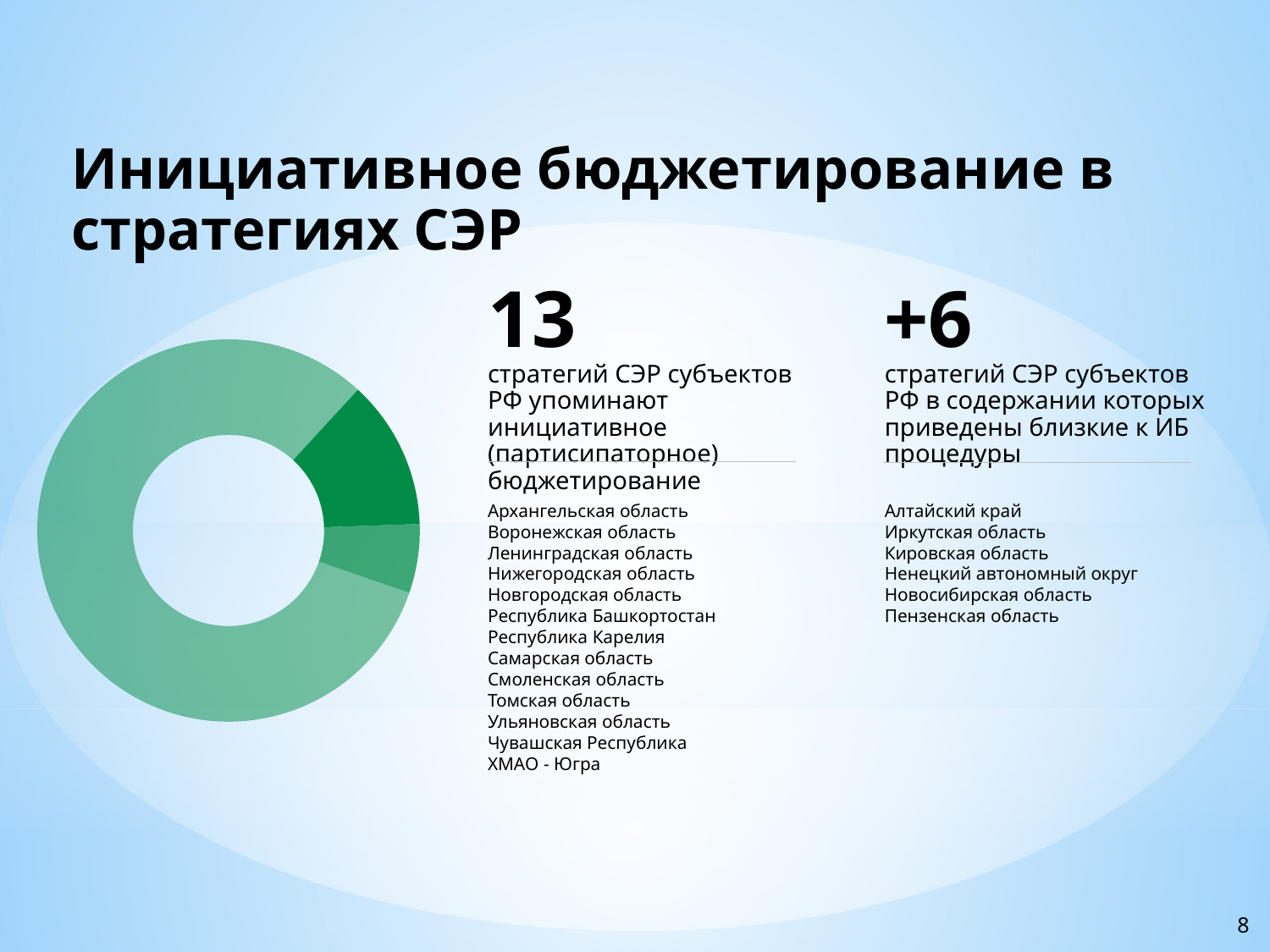
What kind of chart is shown on the left of the slide? doughnut (pie) chart Does the doughnut chart on the slide display a legend? No Which slice of the doughnut chart is the largest: the light green, the dark green, or the medium green one? the light green one How many slices does the doughnut chart on the slide have? 3 Does the doughnut chart on the slide show data labels with values on its slices? No